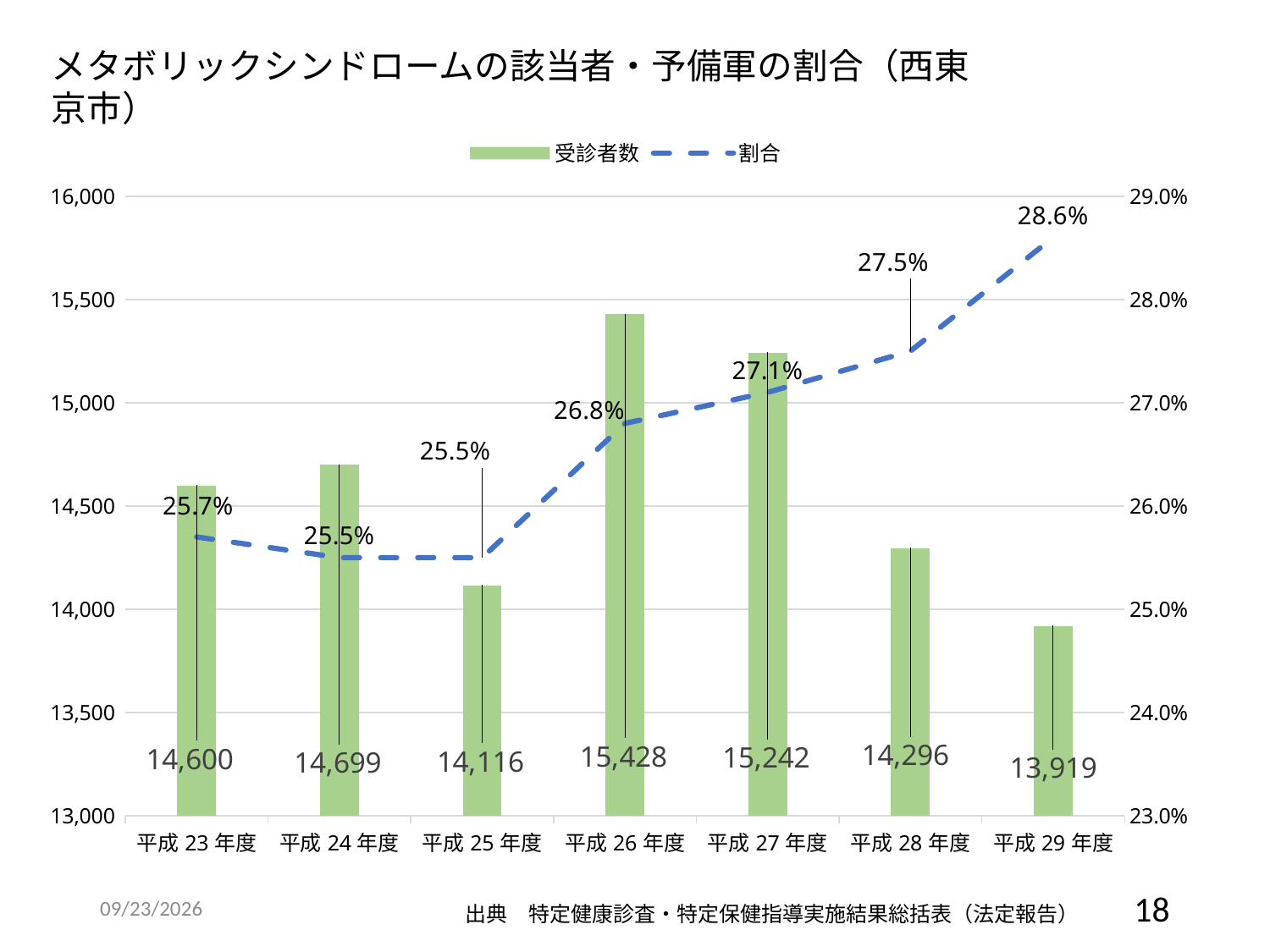
How many years are shown on the x axis? 7 What is the 割合 value for 平成 29 年度? 28.6% What is the 受診者数 value for 平成 26 年度? 15,428 Which year has the highest 受診者数? 平成 26 年度 Which year has the lowest 受診者数? 平成 29 年度 Which is larger, the 受診者数 for 平成 24 年度 or for 平成 28 年度? 平成 24 年度 Which year has the highest 割合? 平成 29 年度 What is the 受診者数 value for 平成 23 年度? 14,600 How many series does the legend list? 2 What is the difference in 受診者数 between 平成 26 年度 and 平成 27 年度? 186 Does the 割合 line rise or fall from 平成 25 年度 to 平成 29 年度? rise What is the 割合 value for 平成 27 年度? 27.1%